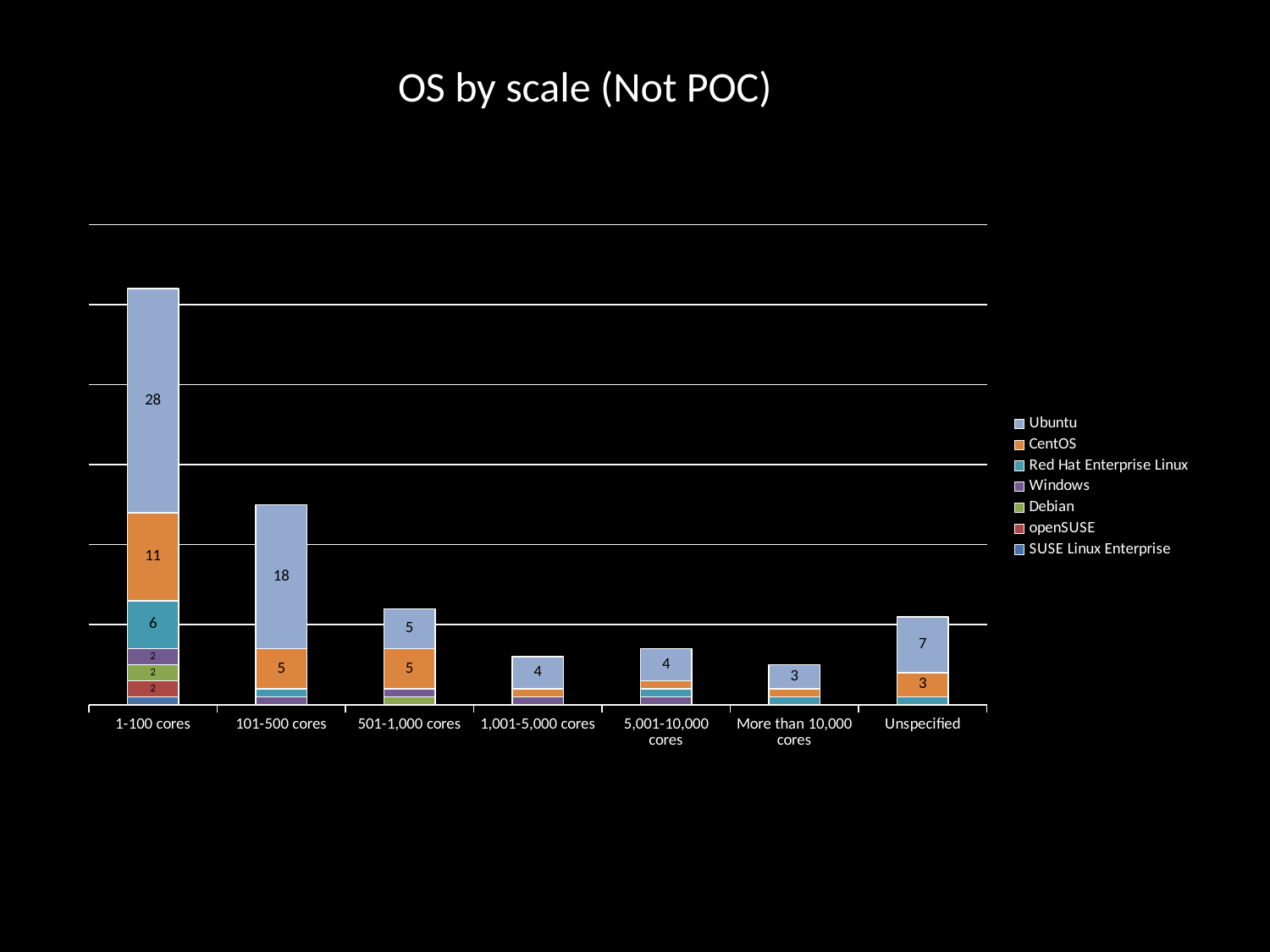
How many scale categories are shown on the x axis? 7 Which category has the highest Ubuntu value? 1-100 cores What is the CentOS value for the 1-100 cores category? 11 Which is larger: the Ubuntu value for 101-500 cores or the Ubuntu value for 501-1,000 cores? 101-500 cores What is the Ubuntu value for the 1-100 cores category? 28 What is the Red Hat Enterprise Linux value for the 1-100 cores category? 6 How many series does the legend list? 7 What type of chart is shown on the slide? stacked bar chart What is the Ubuntu value for the Unspecified category? 7 What is the title of the chart? OS by scale (Not POC) Which series is listed last in the legend? SUSE Linux Enterprise What is the difference between the Ubuntu values for 1-100 cores and 101-500 cores? 10